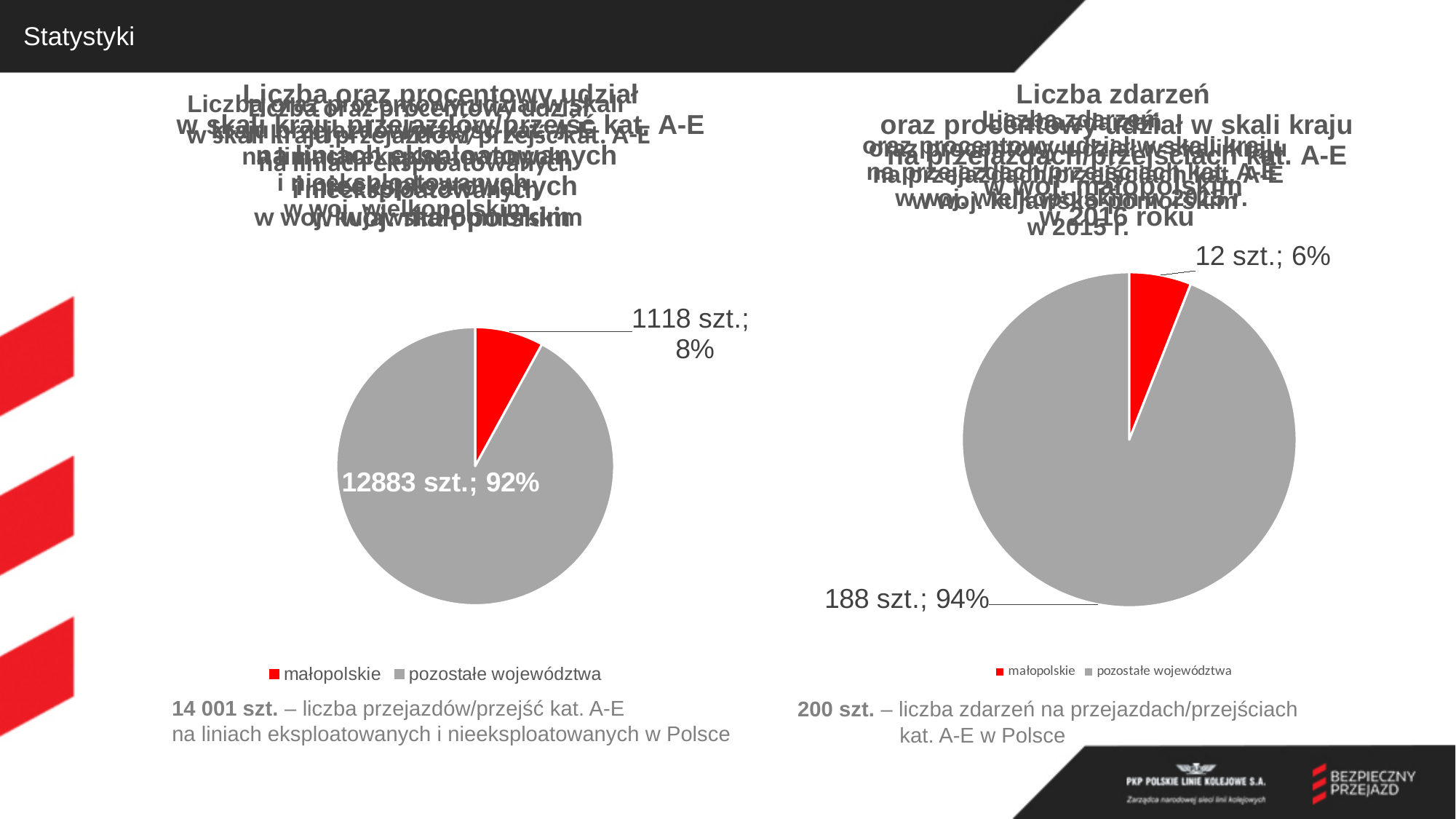
What type of chart is shown on the right side of the slide? pie chart On the left pie chart, which slice is the largest? pozostałe województwa On the right pie chart, what value is shown for małopolskie? 12 szt.; 6% On the left pie chart, what share of the pie does małopolskie have? 8% On the right pie chart, what value is shown for pozostałe województwa? 188 szt.; 94% On the left pie chart, what value is shown for małopolskie? 1118 szt.; 8% On the left pie chart, what value is shown for pozostałe województwa? 12883 szt.; 92% On the right pie chart, what share of the pie does pozostałe województwa have? 94% How many entries does the legend of the left chart list? 2 On the right pie chart, which slice is the smallest? małopolskie On the left pie chart, what is the difference in szt. between pozostałe województwa and małopolskie? 11765 szt. On the right pie chart, what is the total of the two slices in szt.? 200 szt.